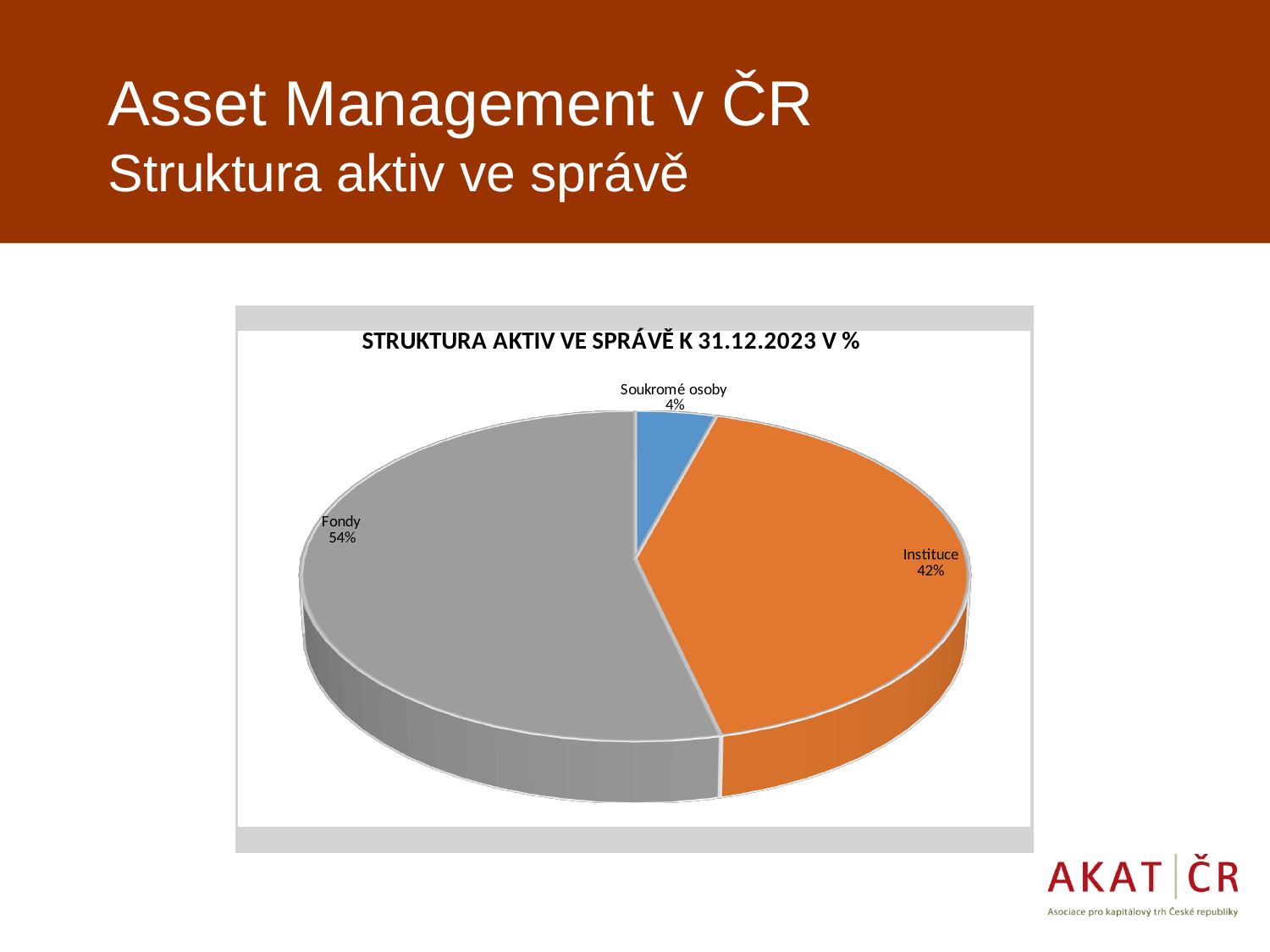
How many categories are shown in the pie chart? 3 Which category has the smallest slice of the pie? Soukromé osoby What is the title of the chart? STRUKTURA AKTIV VE SPRÁVĚ K 31.12.2023 V % Which category has the largest slice of the pie? Fondy What is the difference in percentage points between the Instituce and Soukromé osoby slices? 38 What colour is the Instituce slice? Orange What share of the pie does Instituce hold? 42% What share of the pie does Soukromé osoby hold? 4% Which is larger, the Fondy slice or the Instituce slice? Fondy What kind of chart is shown on the slide? Pie chart What share of the pie does Fondy hold? 54% What is the difference in percentage points between the Fondy and Instituce slices? 12